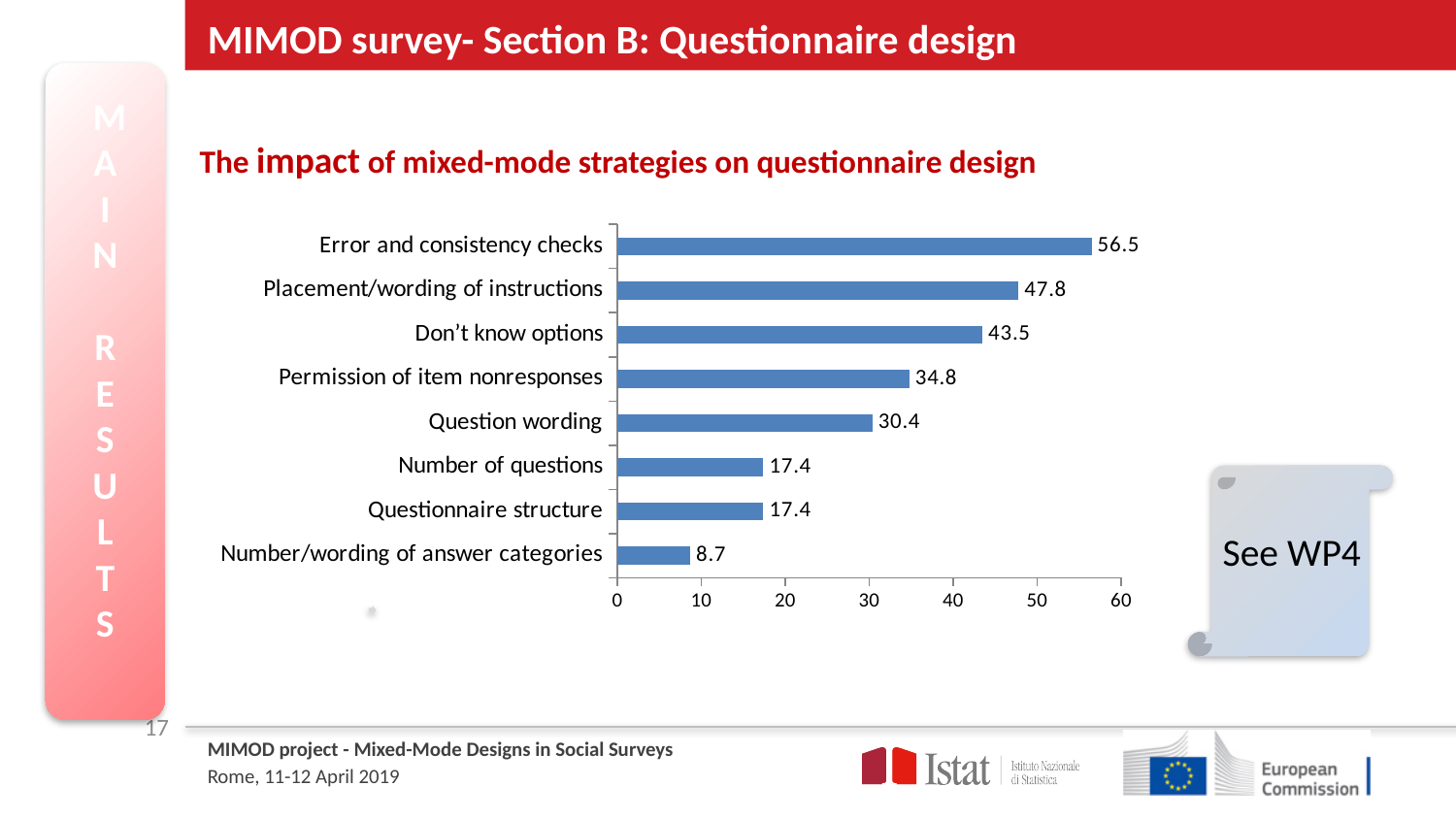
What is the maximum value shown on the horizontal axis? 60 How many categories are shown in the chart? 8 Which category has the lowest value? Number/wording of answer categories What is the difference between the values for Don't know options and Permission of item nonresponses? 8.7 Which is larger, the value for Don't know options or the value for Question wording? Don't know options What is the value for Error and consistency checks? 56.5 Is the value for Permission of item nonresponses greater or less than 30? greater What is the value for Number/wording of answer categories? 8.7 What is the value for Question wording? 30.4 What kind of chart is shown on the slide? Bar chart What is the difference between the values for Error and consistency checks and Placement/wording of instructions? 8.7 Which category has the highest value? Error and consistency checks